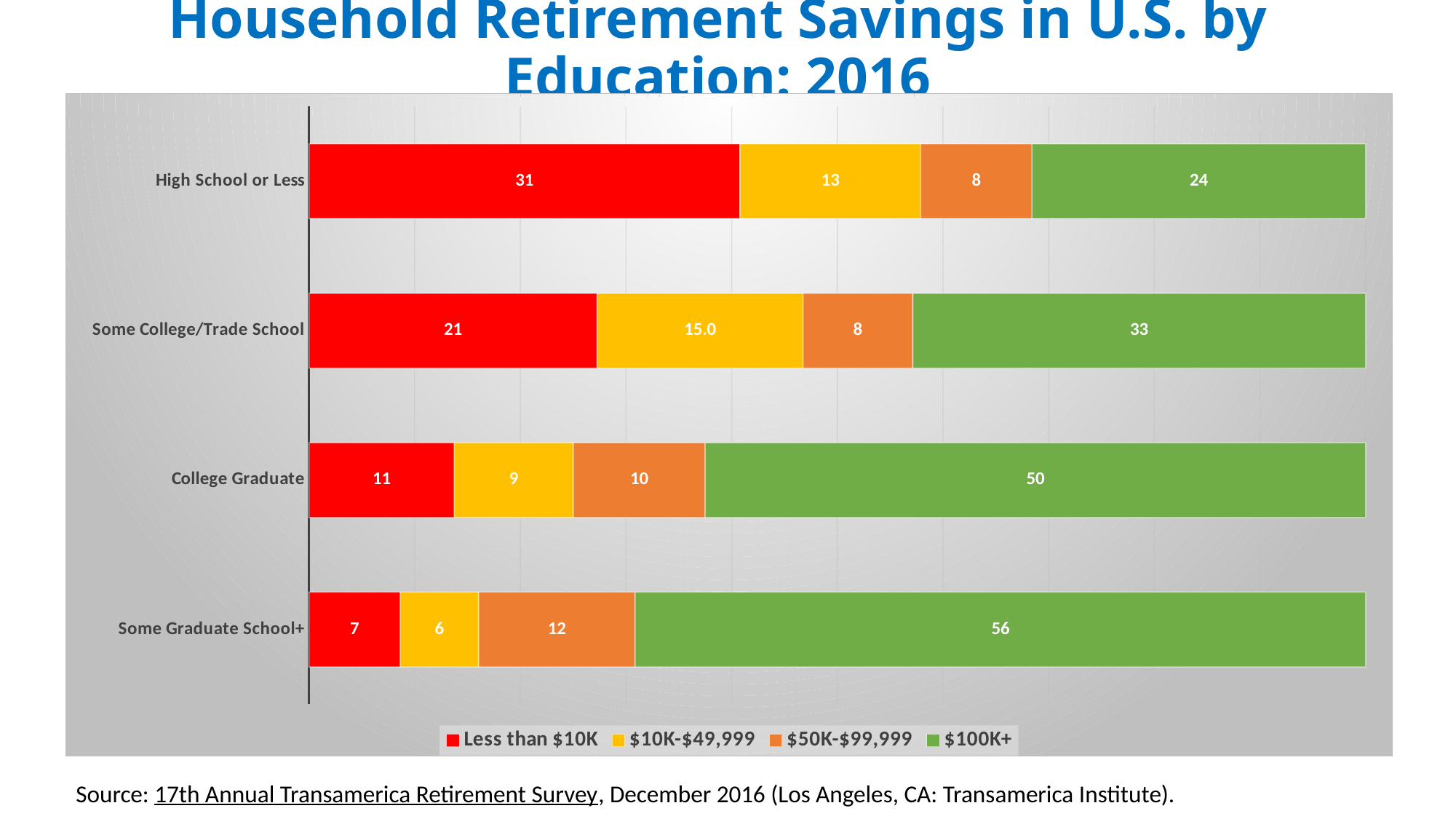
What kind of chart is shown on the slide? Stacked bar chart What is the difference between the $100K+ values for Some Graduate School+ and High School or Less? 32 What is the value for the Less than $10K segment for High School or Less? 31 How many series does the legend list? 4 Which education category has the lowest value for the Less than $10K segment? Some Graduate School+ Which education category has the highest value for the $100K+ segment? Some Graduate School+ What is the value for the $10K-$49,999 segment for Some College/Trade School? 15.0 Which is larger: the Less than $10K value for Some College/Trade School or the Less than $10K value for College Graduate? Some College/Trade School How many education categories are shown on the chart? 4 What is the value for the $100K+ segment for College Graduate? 50 What is the value for the $50K-$99,999 segment for Some Graduate School+? 12 What colour represents the $100K+ series in the chart? Green